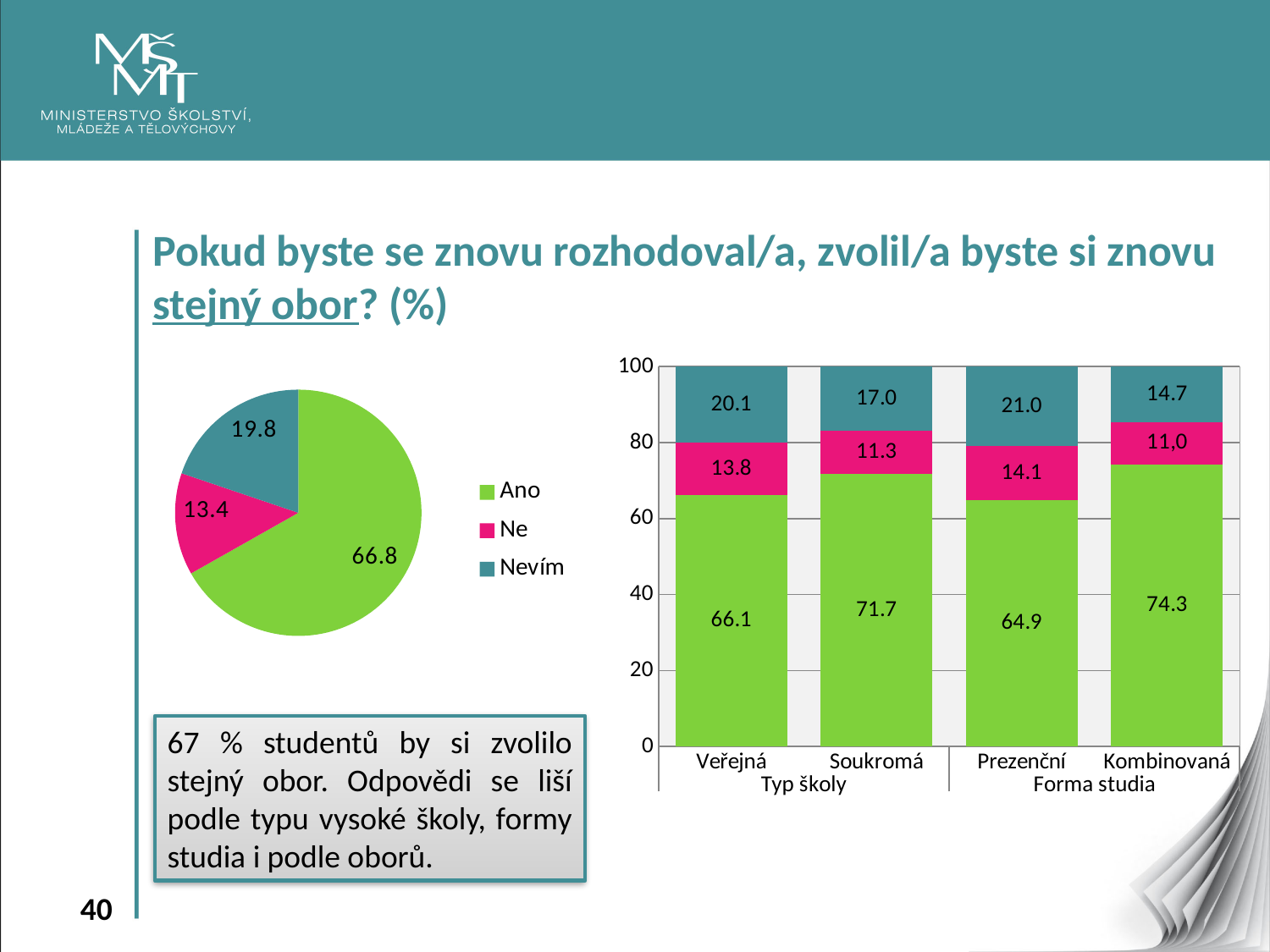
In the pie chart on the left, what is the difference between the Nevím and Ne values? 6.4 In the stacked bar chart on the right, how many categories are shown on the x axis? 4 What type of chart is shown on the right side of the slide? Stacked bar chart In the stacked bar chart on the right, what is the value of the green (Ano) segment for Kombinovaná? 74.3 In the stacked bar chart on the right, which category has the highest green (Ano) value? Kombinovaná In the pie chart on the left, which category has the smallest slice? Ne In the pie chart on the left, how many categories does the legend list? 3 In the stacked bar chart on the right, what is the difference between the green (Ano) values for Kombinovaná and Prezenční? 9.4 In the pie chart on the left, what is the value for Ano? 66.8 In the pie chart on the left, what is the value for Nevím? 19.8 In the stacked bar chart on the right, what is the value of the teal (Nevím) segment for Prezenční? 21.0 In the stacked bar chart on the right, what is the value of the pink (Ne) segment for Soukromá? 11.3